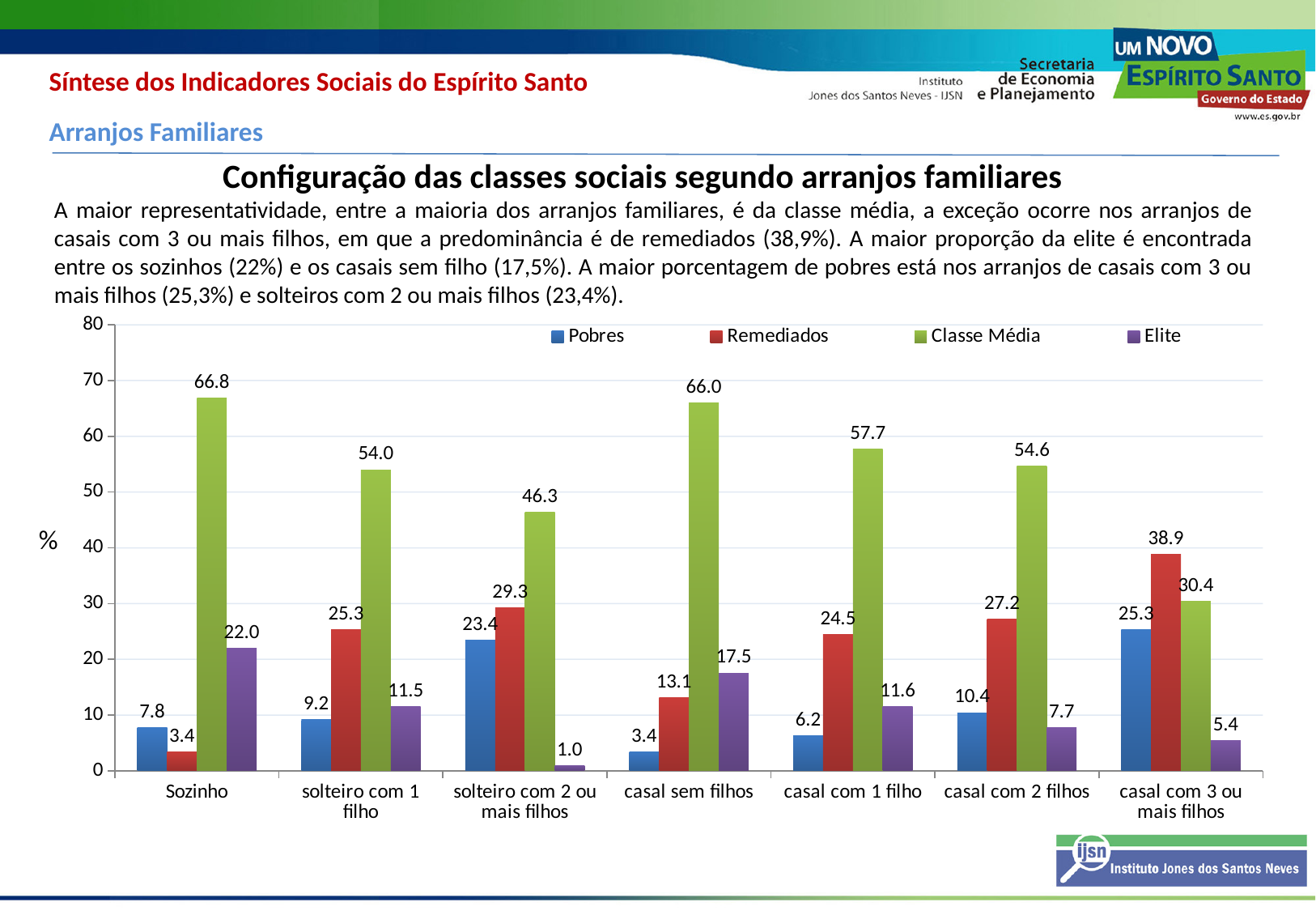
What is the Remediados value for casal com 3 ou mais filhos? 38.9 What is the Pobres value for casal sem filhos? 3.4 Which family arrangement has the highest Elite value? Sozinho Which colour represents the Remediados series in the chart? red How many family arrangement categories are shown on the x axis? 7 What is the Classe Média value for Sozinho? 66.8 What is the difference between the Classe Média values for Sozinho and casal sem filhos? 0.8 Which family arrangement has the lowest Classe Média value? casal com 3 ou mais filhos What is the Elite value for solteiro com 2 ou mais filhos? 1.0 What kind of chart is shown on the slide? bar chart Which is larger: the Pobres value for solteiro com 2 ou mais filhos or the Pobres value for casal com 3 ou mais filhos? casal com 3 ou mais filhos How many series does the legend list? 4